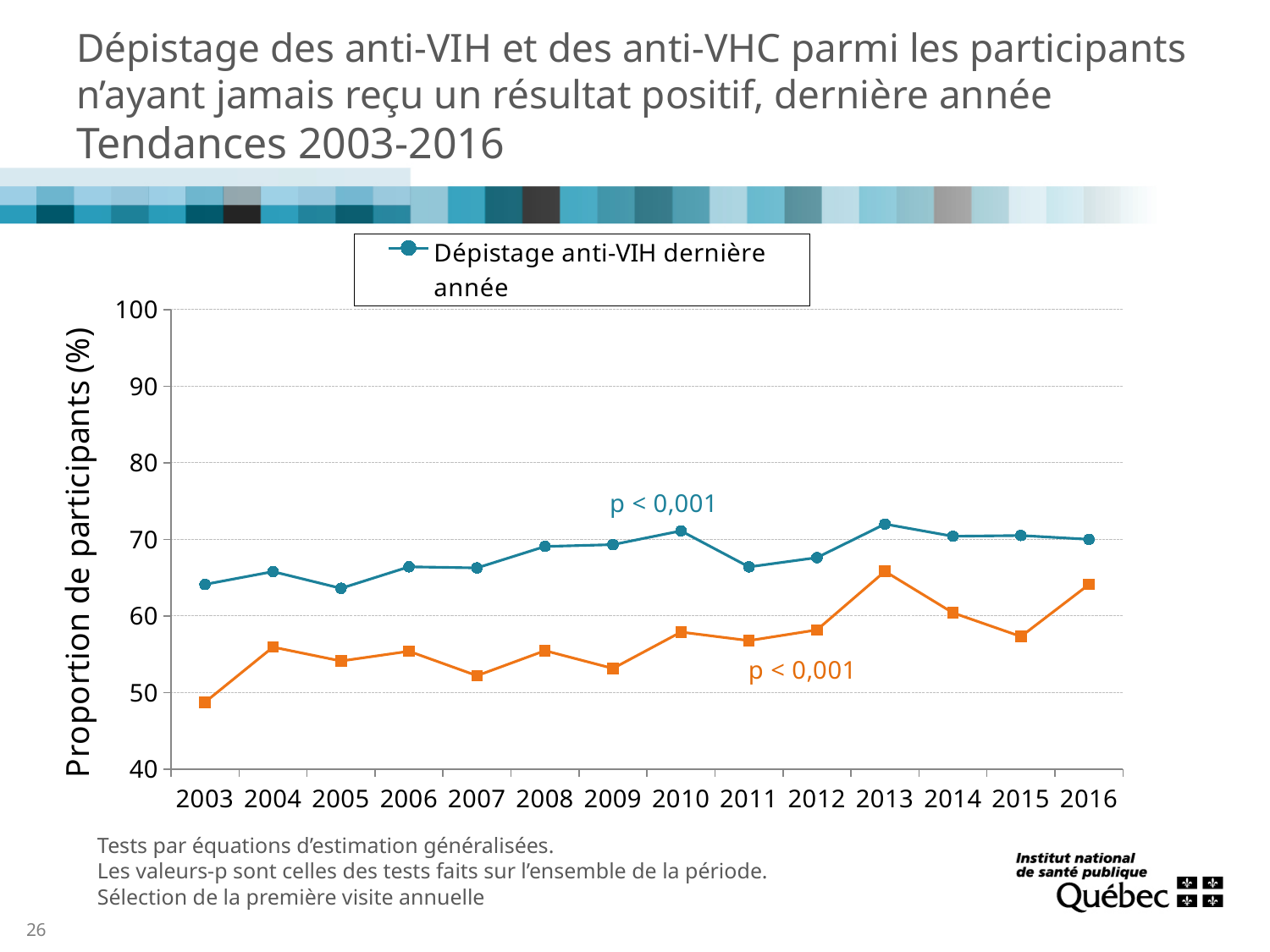
Which is higher for 'Dépistage anti-VIH dernière année': the value in 2003 or the value in 2013? 2013 What is the label of the y axis of the chart? Proportion de participants (%) Is the value of the orange line in 2003 greater or less than 50? less Is the value for 'Dépistage anti-VIH dernière année' in 2005 greater or less than 70? less In which year is the orange line at its highest? 2013 Is the value of the orange line in 2013 greater or less than 60? greater How many years are plotted along the x axis of the chart? 14 In 2003, which line is higher: the blue line or the orange line? The blue line What kind of chart is shown on the slide? Line chart In which year is the orange line at its lowest? 2003